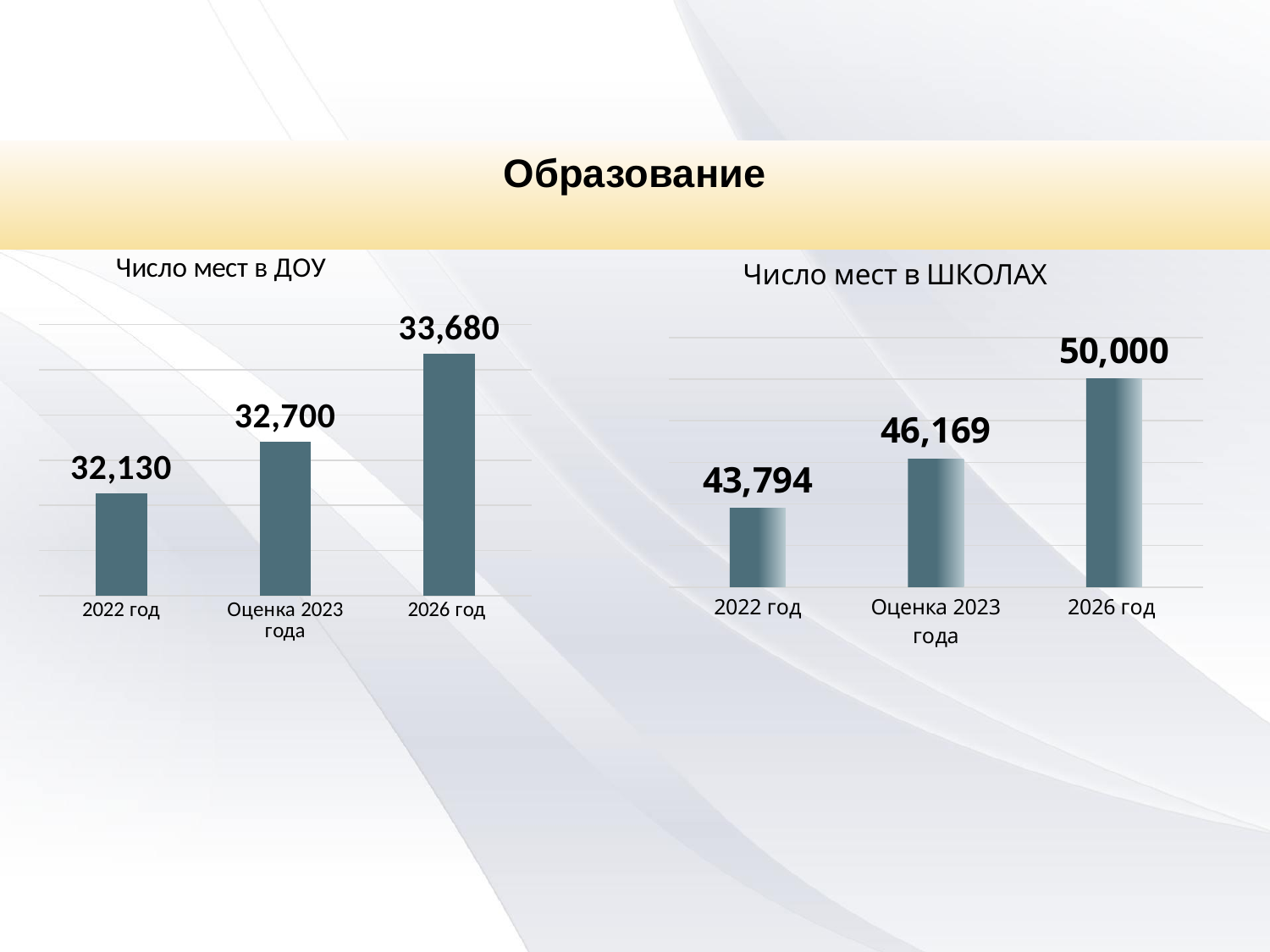
In the chart titled 'Число мест в ДОУ', which category has the highest value? 2026 год In the chart titled 'Число мест в ДОУ', what is the value for Оценка 2023 года? 32,700 What kind of chart is the chart titled 'Число мест в ШКОЛАХ'? bar chart In the chart titled 'Число мест в ШКОЛАХ', what is the value for 2026 год? 50,000 In the chart titled 'Число мест в ШКОЛАХ', what is the difference between the values for Оценка 2023 года and 2022 год? 2,375 In the chart titled 'Число мест в ДОУ', do the values rise or fall from 2022 год to 2026 год? rise In the chart titled 'Число мест в ШКОЛАХ', which is larger: the value for 2026 год or the value for Оценка 2023 года? 2026 год How many categories are shown in the chart titled 'Число мест в ДОУ'? 3 In the chart titled 'Число мест в ДОУ', what is the value for 2022 год? 32,130 In the chart titled 'Число мест в ДОУ', what is the difference between the values for 2026 год and 2022 год? 1,550 In the chart titled 'Число мест в ШКОЛАХ', what is the value for 2022 год? 43,794 In the chart titled 'Число мест в ШКОЛАХ', which category has the lowest value? 2022 год